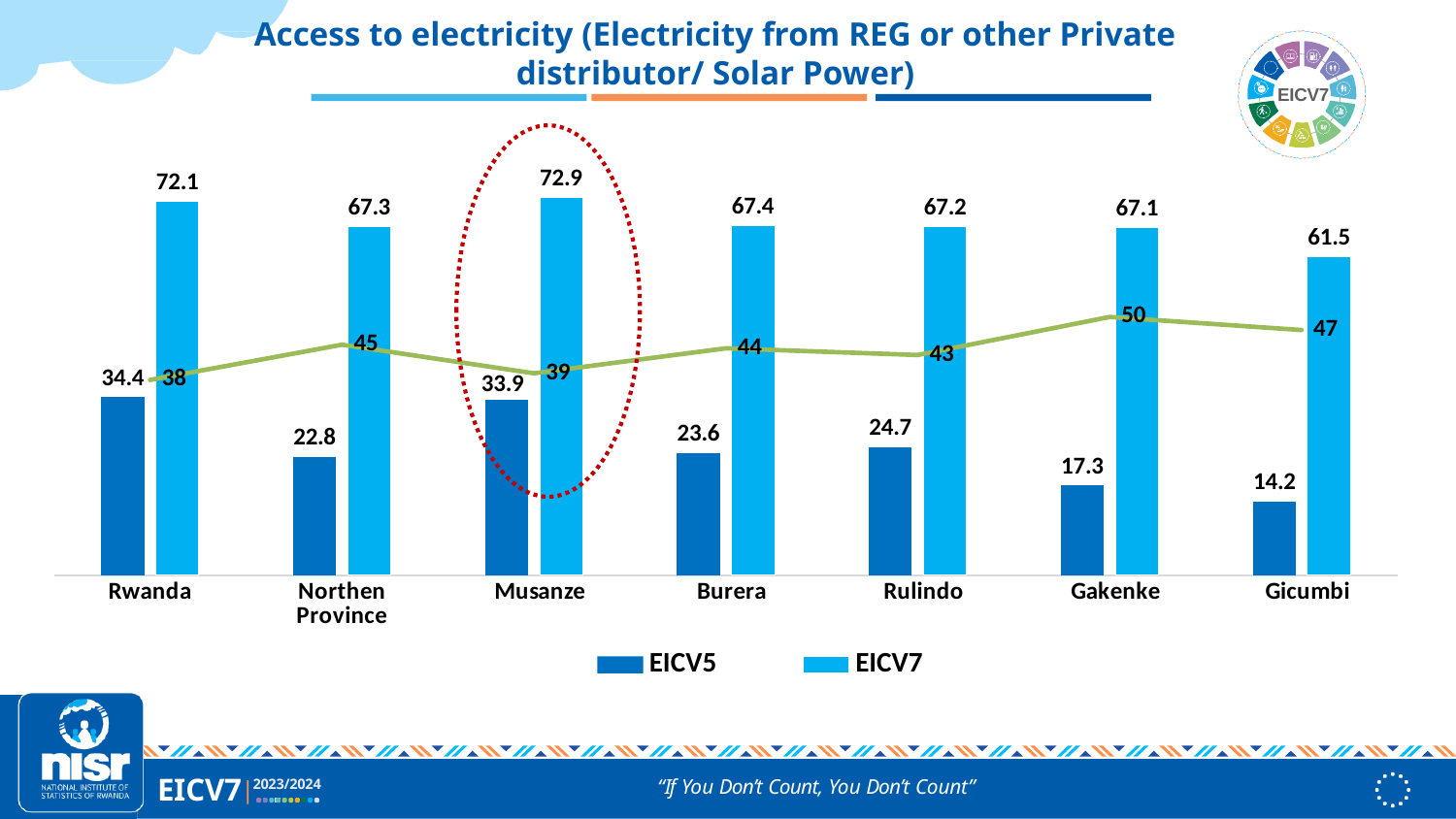
What is the difference between the EICV7 and EICV5 values for Musanze? 39 What is the difference between the EICV7 and EICV5 values for Gicumbi? 47.3 What is the EICV7 value for Musanze? 72.9 What is the EICV5 value for Gakenke? 17.3 How many series does the legend list? 2 What is the EICV7 value for Gicumbi? 61.5 Which category has the lowest EICV5 value? Gicumbi What is the EICV5 value for Rwanda? 34.4 Which is larger, the EICV5 value for Burera or the EICV5 value for Rulindo? Rulindo Which category has the highest EICV7 value? Musanze How many categories are shown on the x axis? 7 What kind of chart is shown on the slide? Combination bar and line chart